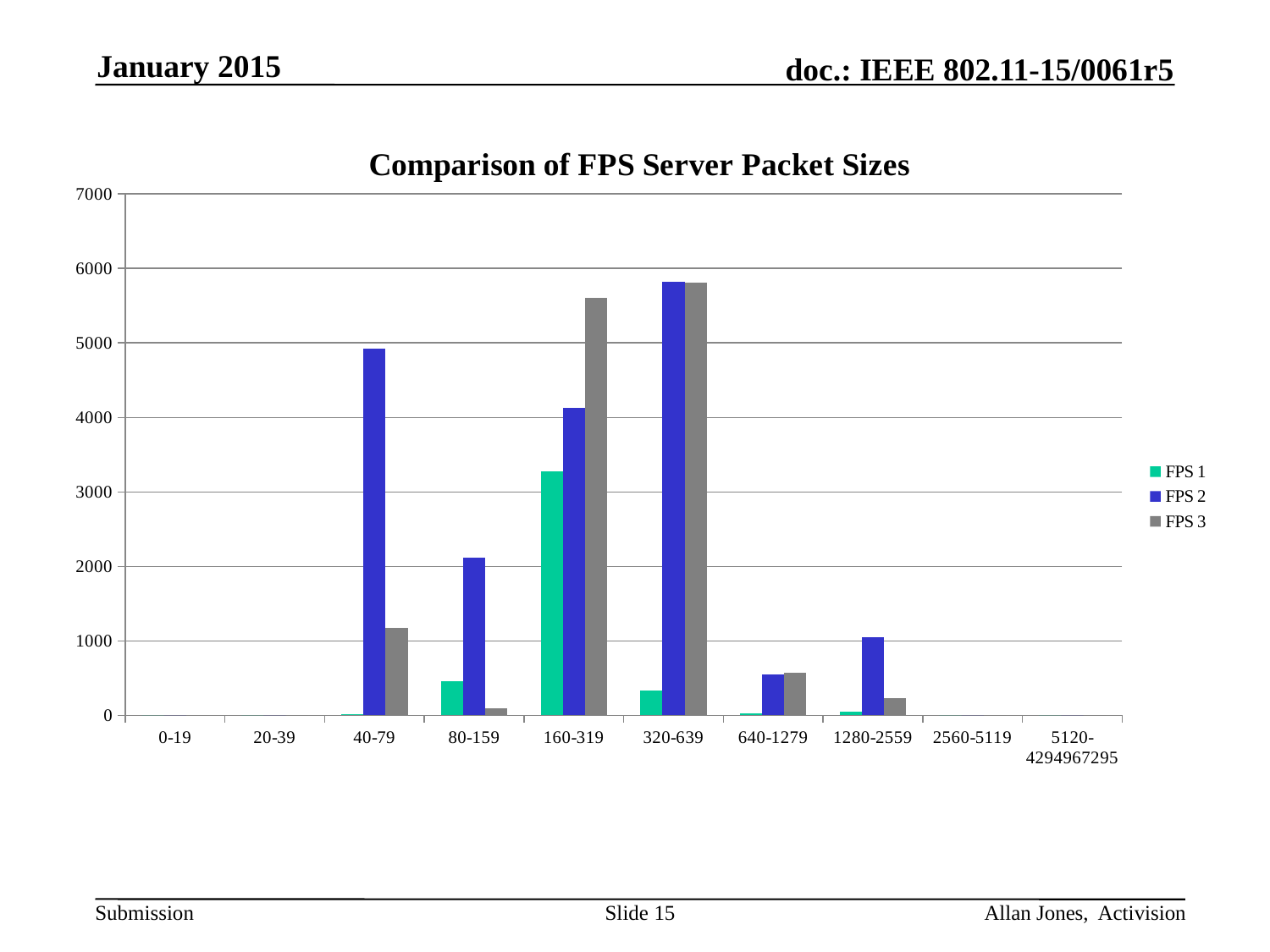
How many packet size categories are shown on the x axis? 10 In the 160-319 category, which series has the highest value? FPS 3 Is the value for FPS 2 in the 1280-2559 category greater or less than 2000? less Is the value for FPS 1 in the 160-319 category greater or less than 3000? greater Is the value for FPS 3 in the 160-319 category greater or less than 5000? greater What kind of chart is shown on the slide? bar chart What is the title of the chart? Comparison of FPS Server Packet Sizes Which packet size category has the highest value for FPS 2? 320-639 How many series does the legend list? 3 Which packet size category has the highest value for FPS 1? 160-319 In the 40-79 category, which is larger, FPS 2 or FPS 3? FPS 2